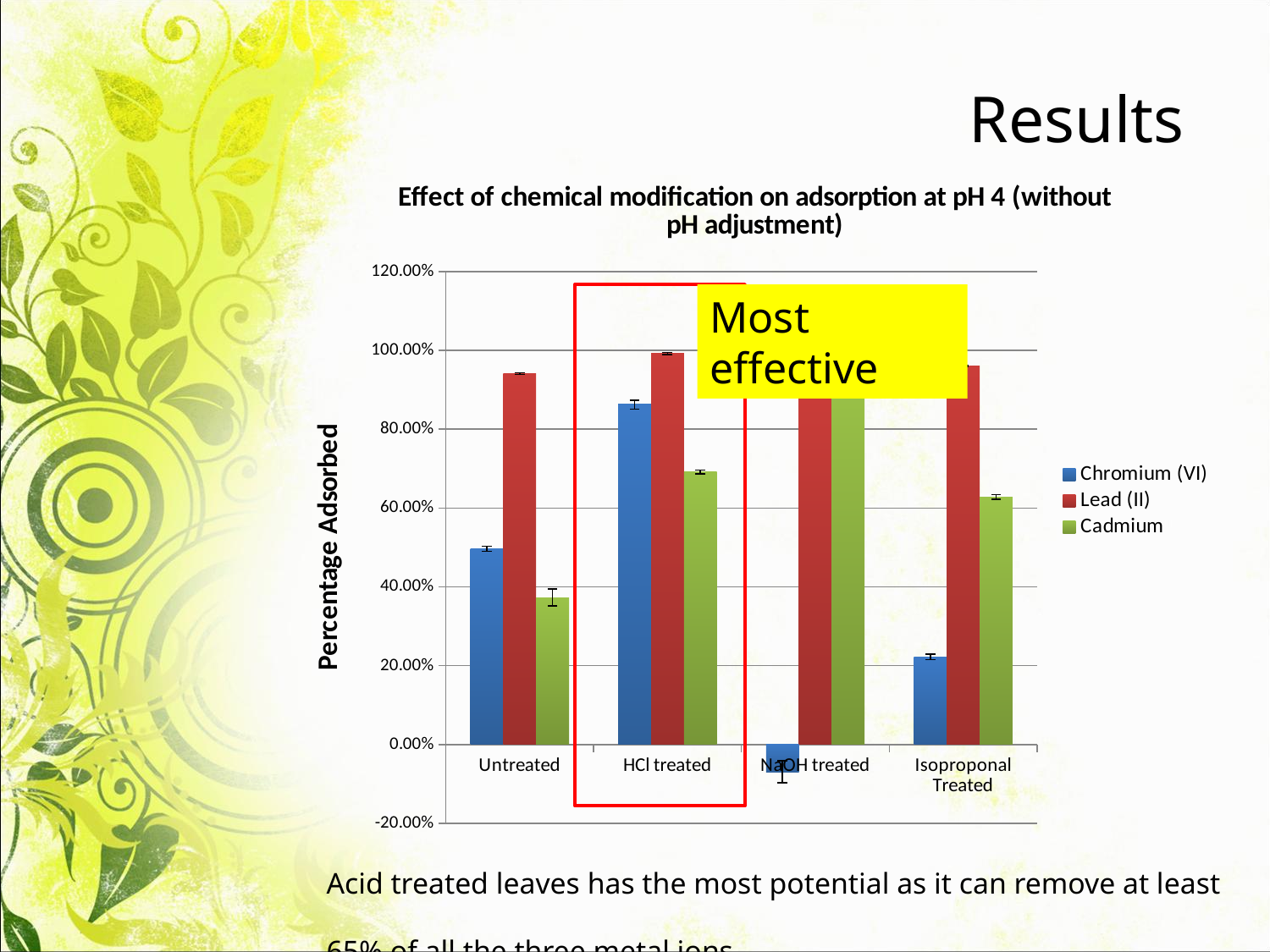
What kind of chart is shown on the slide? bar chart Which is larger: the Chromium (VI) value for HCl treated or for Isoproponal Treated? HCl treated Is the Chromium (VI) value for NaOH treated greater or less than 0.00%? less Is the Cadmium value for HCl treated greater or less than 60.00%? greater Which treatment has the highest Chromium (VI) percentage adsorbed? HCl treated Which treatment has the lowest Chromium (VI) percentage adsorbed? NaOH treated Is the Chromium (VI) value for HCl treated greater or less than 80.00%? greater For the Untreated category, which is larger: the Chromium (VI) value or the Cadmium value? Chromium (VI) What is the title of the chart? Effect of chemical modification on adsorption at pH 4 (without pH adjustment) How many series does the chart's legend list? 3 How many treatment categories are shown on the x axis? 4